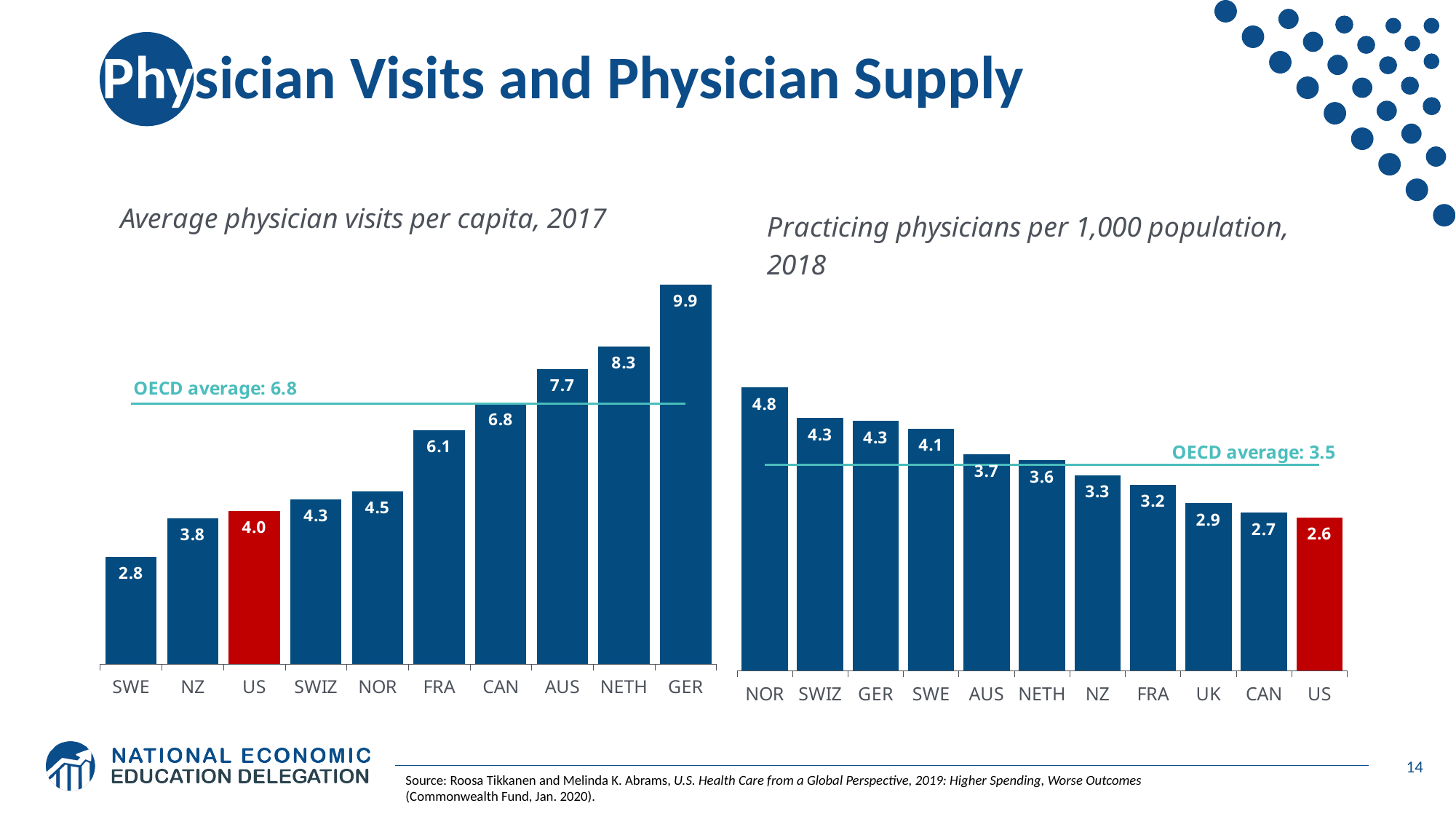
In the 'Practicing physicians per 1,000 population, 2018' chart, what is the difference between NOR and US? 2.2 In the 'Average physician visits per capita, 2017' chart, what OECD average is shown? 6.8 In the 'Average physician visits per capita, 2017' chart, how many countries are shown? 10 What kind of chart is the 'Practicing physicians per 1,000 population, 2018' chart? Bar chart In the 'Average physician visits per capita, 2017' chart, which country has the lowest value? SWE In the 'Average physician visits per capita, 2017' chart, what is the value for GER? 9.9 In the 'Practicing physicians per 1,000 population, 2018' chart, which is larger, the value for UK or the value for CAN? UK In the 'Practicing physicians per 1,000 population, 2018' chart, which country has the lowest value? US In the 'Average physician visits per capita, 2017' chart, what is the difference between NETH and US? 4.3 In the 'Practicing physicians per 1,000 population, 2018' chart, how many countries are shown? 11 In the 'Practicing physicians per 1,000 population, 2018' chart, what is the value for NOR? 4.8 In the 'Practicing physicians per 1,000 population, 2018' chart, do the values rise or fall from left to right? Fall